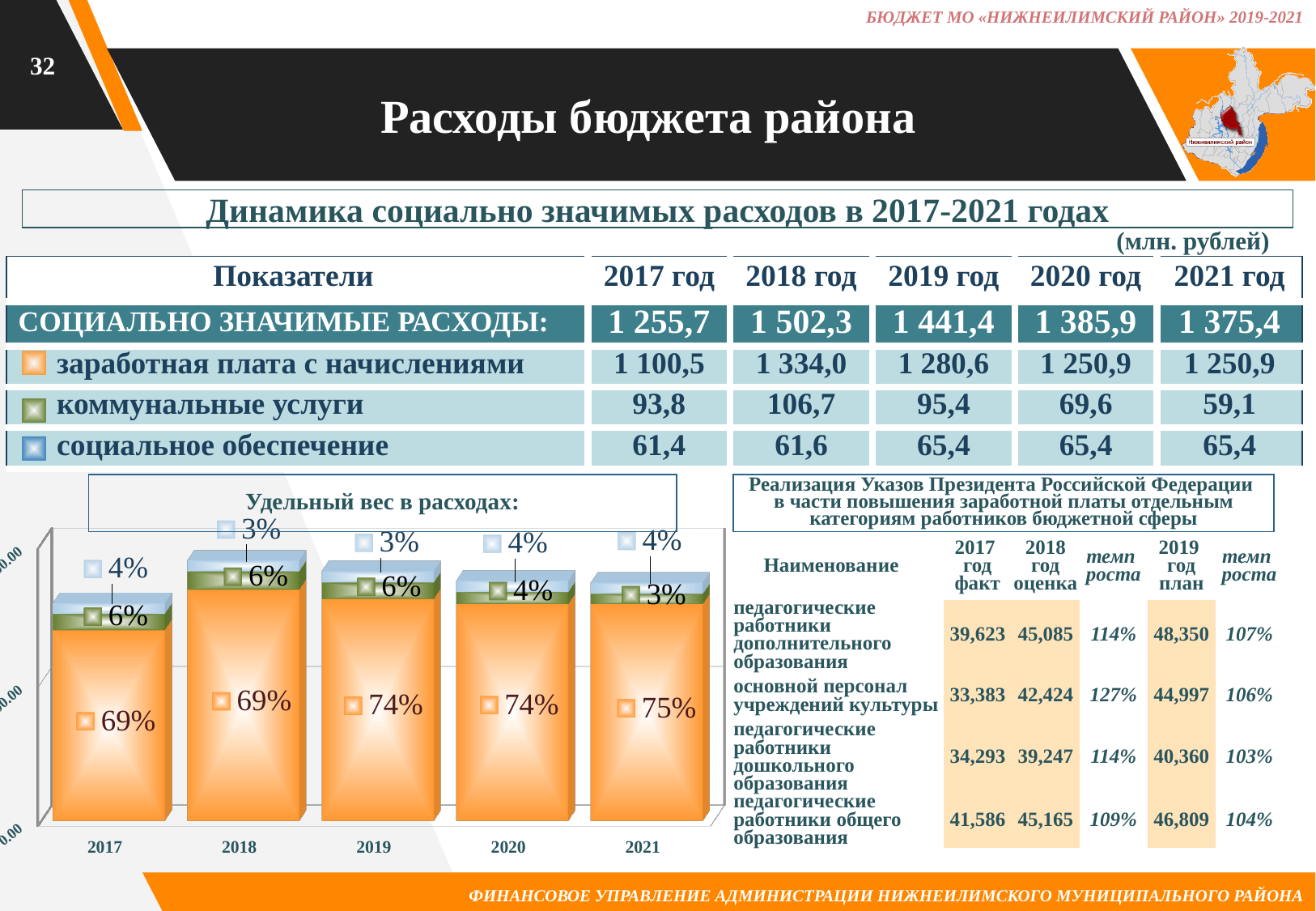
In the "Удельный вес в расходах:" chart, what is the value of the orange segment for 2017? 69% What kind of chart is shown under the heading "Удельный вес в расходах:"? bar chart In the "Удельный вес в расходах:" chart, what is the value of the green segment for 2018? 6% In the "Удельный вес в расходах:" chart, which year has the larger orange segment, 2018 or 2019? 2019 In the "Удельный вес в расходах:" chart, what is the value of the blue segment for 2020? 4% In the "Удельный вес в расходах:" chart, which year has the lowest value for the green segment? 2021 How many years are shown on the x axis of the "Удельный вес в расходах:" chart? 5 In the "Удельный вес в расходах:" chart, which year has the highest value for the orange segment? 2021 In the "Удельный вес в расходах:" chart, by how many percentage points is the orange segment for 2021 larger than for 2017? 6 In the "Удельный вес в расходах:" chart, what is the value of the orange segment for 2021? 75% In the "Удельный вес в расходах:" chart, does the orange segment's share rise or fall from 2017 to 2021? rises In the "Удельный вес в расходах:" chart, what is the sum of the three labelled segments for 2017? 79%